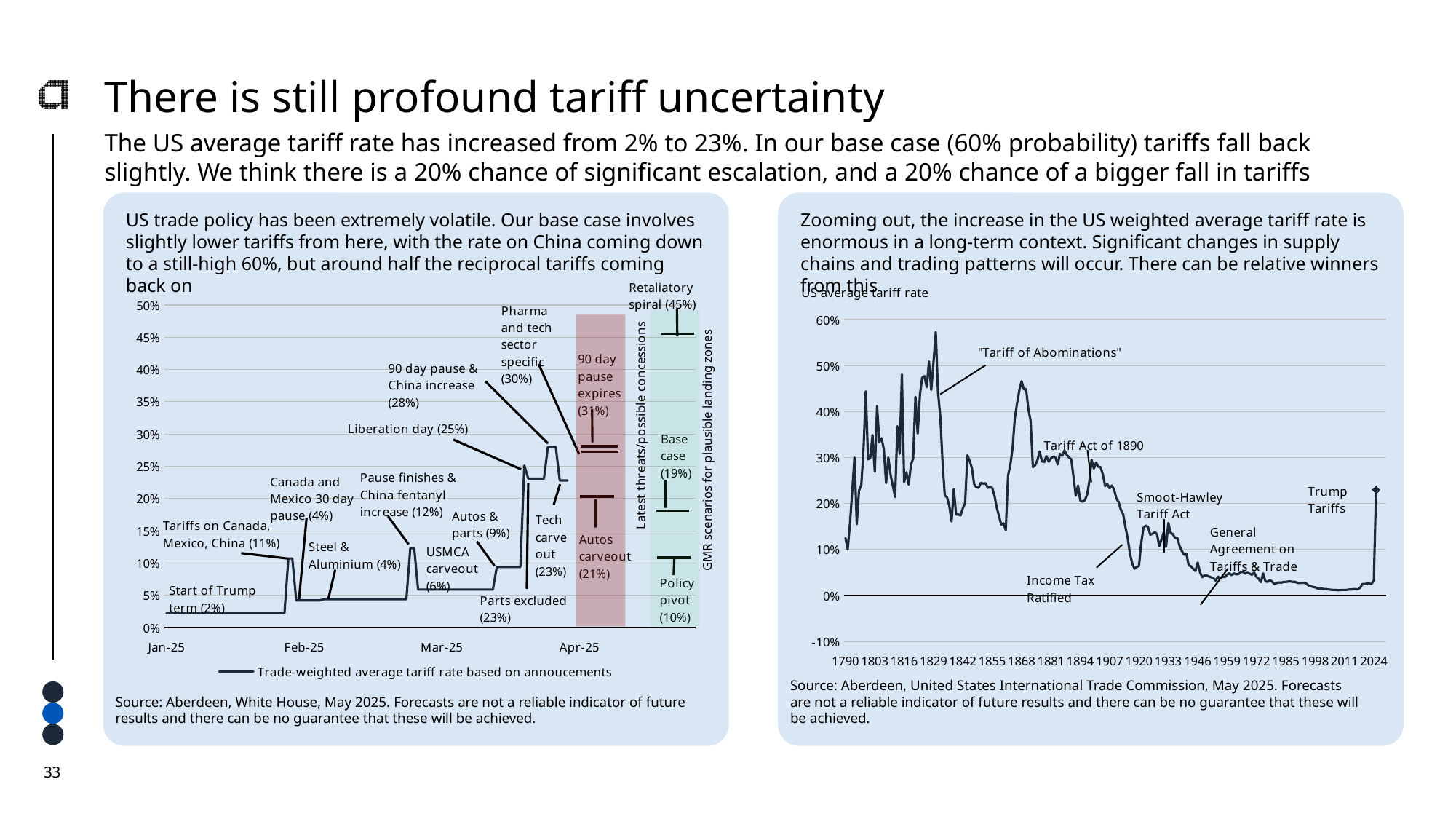
On the left chart, what tariff rate is labelled for Liberation day? 25% On the left chart, what is the trade-weighted average tariff rate at the start of Trump's term? 2% On the right chart, is the peak US average tariff rate around 1830 greater or less than 50%? greater On the left chart, what series does the legend list? Trade-weighted average tariff rate based on annoucements On the left chart, what is the tariff rate in the Retaliatory spiral scenario? 45% On the left chart, which of the three GMR scenarios for plausible landing zones has the highest tariff rate? Retaliatory spiral On the left chart, what is the tariff rate in the Base case scenario? 19% On the left chart, what is the difference between the Liberation day rate and the 90 day pause & China increase rate? 3% On the left chart, which is higher: the rate when the 90 day pause expires or the rate after the Autos carveout? 90 day pause expires What type of chart is the right-hand chart titled 'US average tariff rate'? line chart On the left chart, what is the difference between the Retaliatory spiral rate and the Policy pivot rate? 35% On the left chart, what is the tariff rate in the Policy pivot scenario? 10%